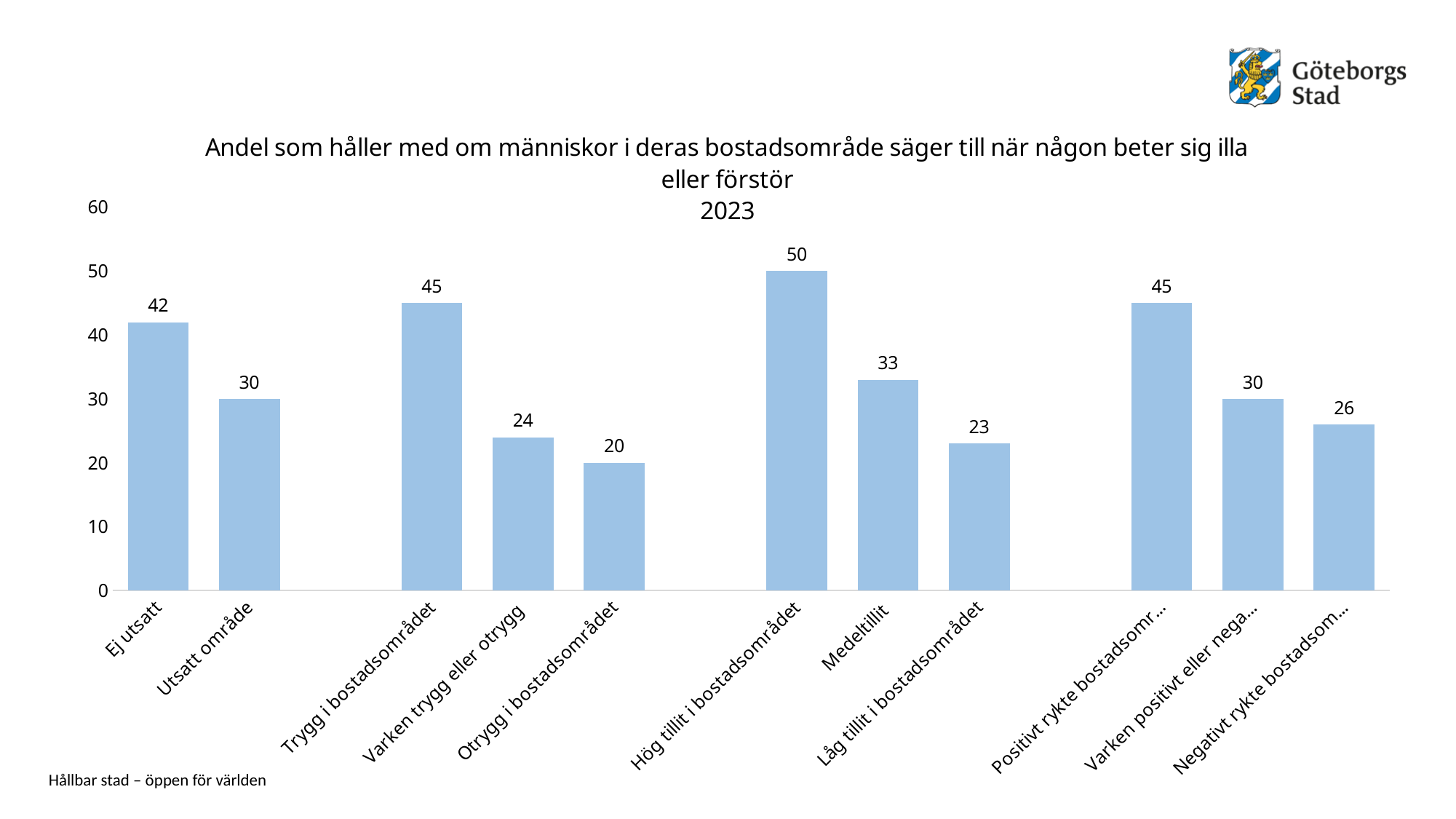
Which category has the highest value? Hög tillit i bostadsområdet What is the value for Utsatt område? 30 How many bars are shown in the chart? 11 What kind of chart is this? bar chart What is the value for Otrygg i bostadsområdet? 20 What is the difference between Trygg i bostadsområdet and Otrygg i bostadsområdet? 25 What is the value for Medeltillit? 33 Which category has the lowest value? Otrygg i bostadsområdet Which is larger, Ej utsatt or Utsatt område? Ej utsatt Is the value for Låg tillit i bostadsområdet greater or less than 30? less What is the value for Ej utsatt? 42 What year is shown in the chart title? 2023